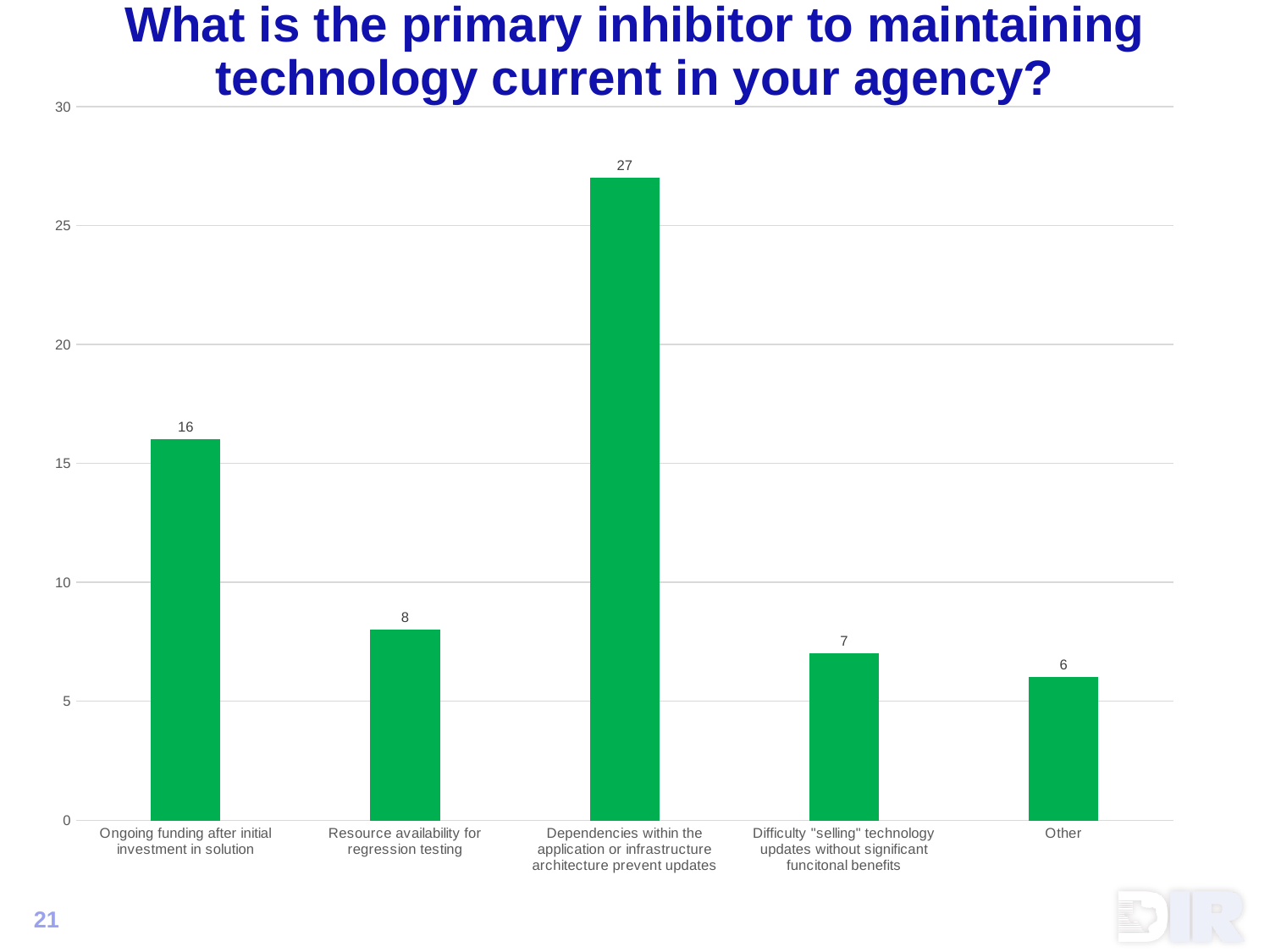
What colour are the bars in the chart? green Which category has the lowest value? Other What is the difference between the values for "Dependencies within the application or infrastructure architecture prevent updates" and "Ongoing funding after initial investment in solution"? 11 What is the title of the chart? What is the primary inhibitor to maintaining technology current in your agency? What is the value for "Ongoing funding after initial investment in solution"? 16 Which is larger: the value for "Resource availability for regression testing" or the value for "Difficulty "selling" technology updates without significant funcitonal benefits"? Resource availability for regression testing How many categories are shown on the chart? 5 Which category has the highest value? Dependencies within the application or infrastructure architecture prevent updates Is the value for "Ongoing funding after initial investment in solution" greater or less than 20? less What kind of chart is shown on the slide? bar chart What is the value for "Other"? 6 What is the value for "Dependencies within the application or infrastructure architecture prevent updates"? 27